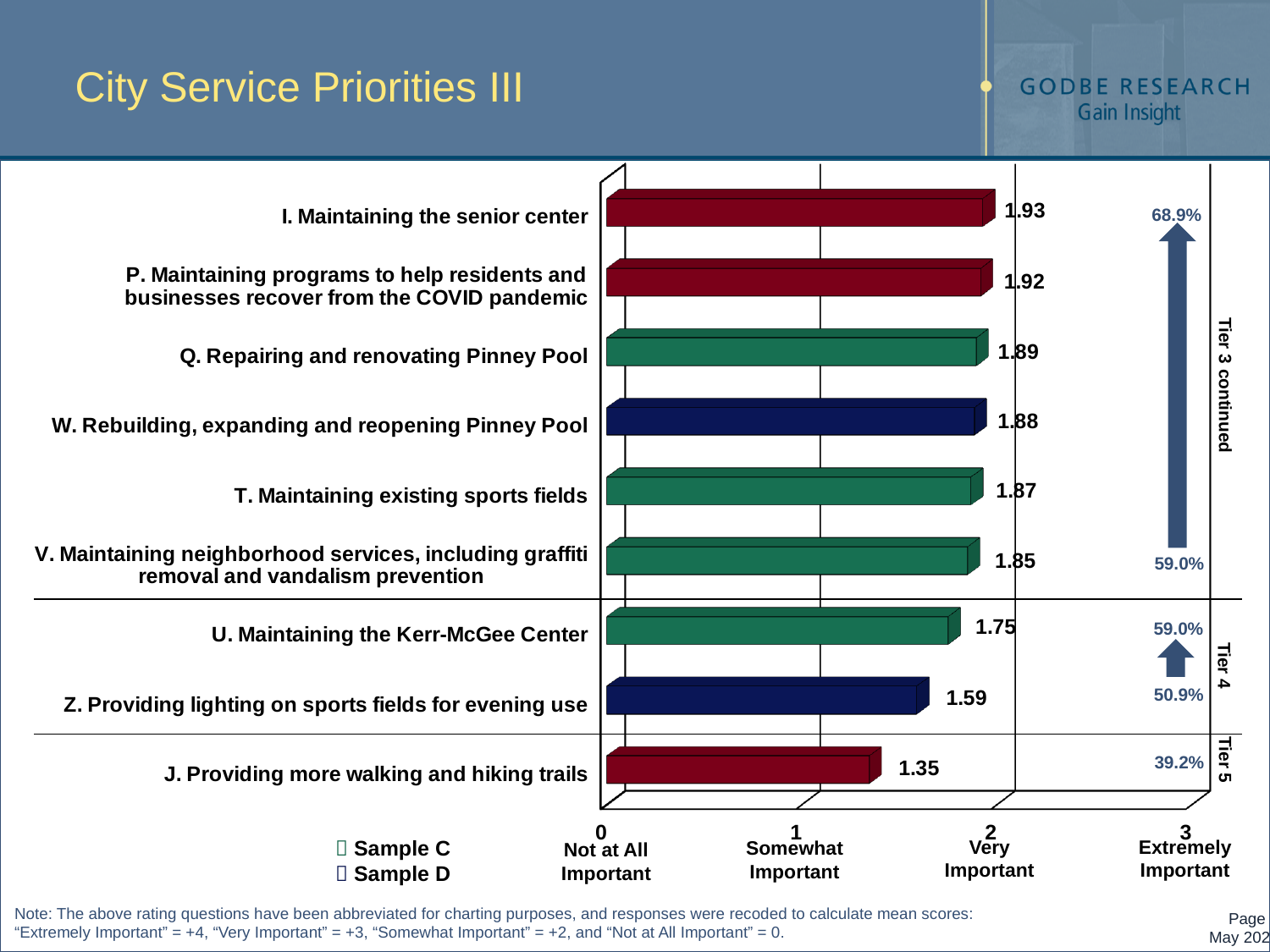
Which category has the highest mean score? I. Maintaining the senior center What is the mean score for 'I. Maintaining the senior center'? 1.93 What kind of chart is shown on the slide? bar chart What is the mean score for 'U. Maintaining the Kerr-McGee Center'? 1.75 What is the difference between the mean scores for 'I. Maintaining the senior center' and 'J. Providing more walking and hiking trails'? 0.58 Which category has the lowest mean score? J. Providing more walking and hiking trails Is the mean score for 'J. Providing more walking and hiking trails' greater or less than 1? greater How many categories are plotted in the chart? 9 Which has a higher mean score, 'T. Maintaining existing sports fields' or 'U. Maintaining the Kerr-McGee Center'? T. Maintaining existing sports fields What is the difference between the mean scores for 'U. Maintaining the Kerr-McGee Center' and 'Z. Providing lighting on sports fields for evening use'? 0.16 What is the mean score for 'Z. Providing lighting on sports fields for evening use'? 1.59